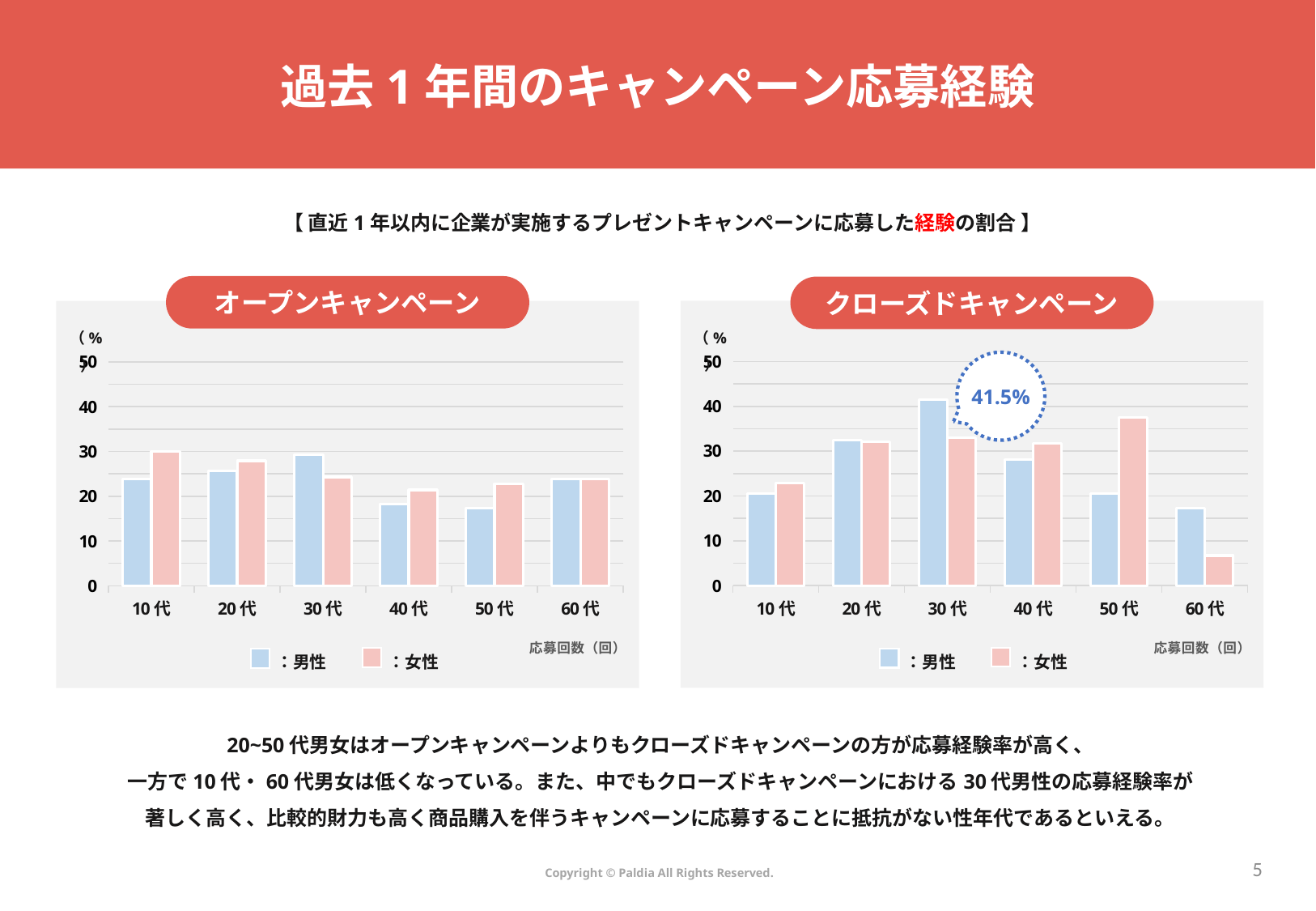
In the クローズドキャンペーン chart, which bar is the lowest? 60代 女性 In the クローズドキャンペーン chart, which colour represents 女性 in the legend? pink In the オープンキャンペーン chart, is the value for 50代 男性 greater or less than 20? less How many age groups are shown on the x axis of the クローズドキャンペーン chart? 6 In the クローズドキャンペーン chart, is the value for 60代 女性 greater or less than 10? less In the クローズドキャンペーン chart, is the value for 50代 女性 greater or less than 30? greater In the オープンキャンペーン chart, which is larger for the 30代 group, 男性 or 女性? 男性 In the クローズドキャンペーン chart, which is larger for the 50代 group, 男性 or 女性? 女性 In the クローズドキャンペーン chart, what is the value for 男性 in the 30代 group? 41.5% How many series does the legend of the オープンキャンペーン chart list? 2 What kind of chart is the オープンキャンペーン chart? bar chart In the クローズドキャンペーン chart, which bar is the highest? 30代 男性